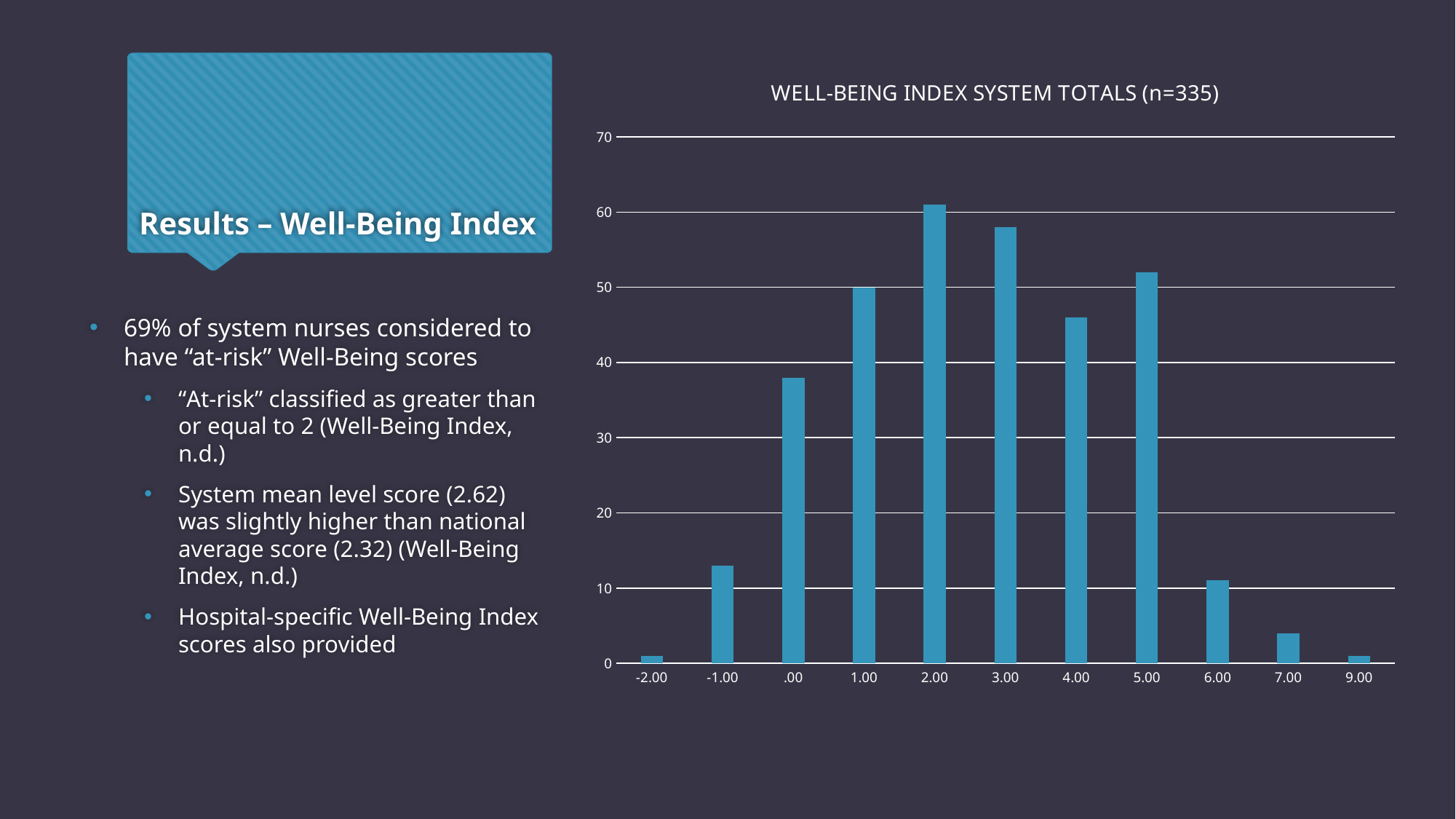
What is the title of the chart? WELL-BEING INDEX SYSTEM TOTALS (n=335) Is the value for 4.00 greater or less than 50? less Do the values rise or fall from 5.00 to 9.00 along the x axis? fall How many categories are shown on the x axis of the chart? 11 Is the value for 3.00 greater or less than 50? greater Do the values rise or fall from -2.00 to 2.00 along the x axis? rise What kind of chart is shown on the slide? Bar chart Is the value for .00 greater or less than 40? less Which is larger, the value for 4.00 or the value for 5.00? 5.00 Which is larger, the value for 3.00 or the value for 5.00? 3.00 Which category has the highest bar in the chart? 2.00